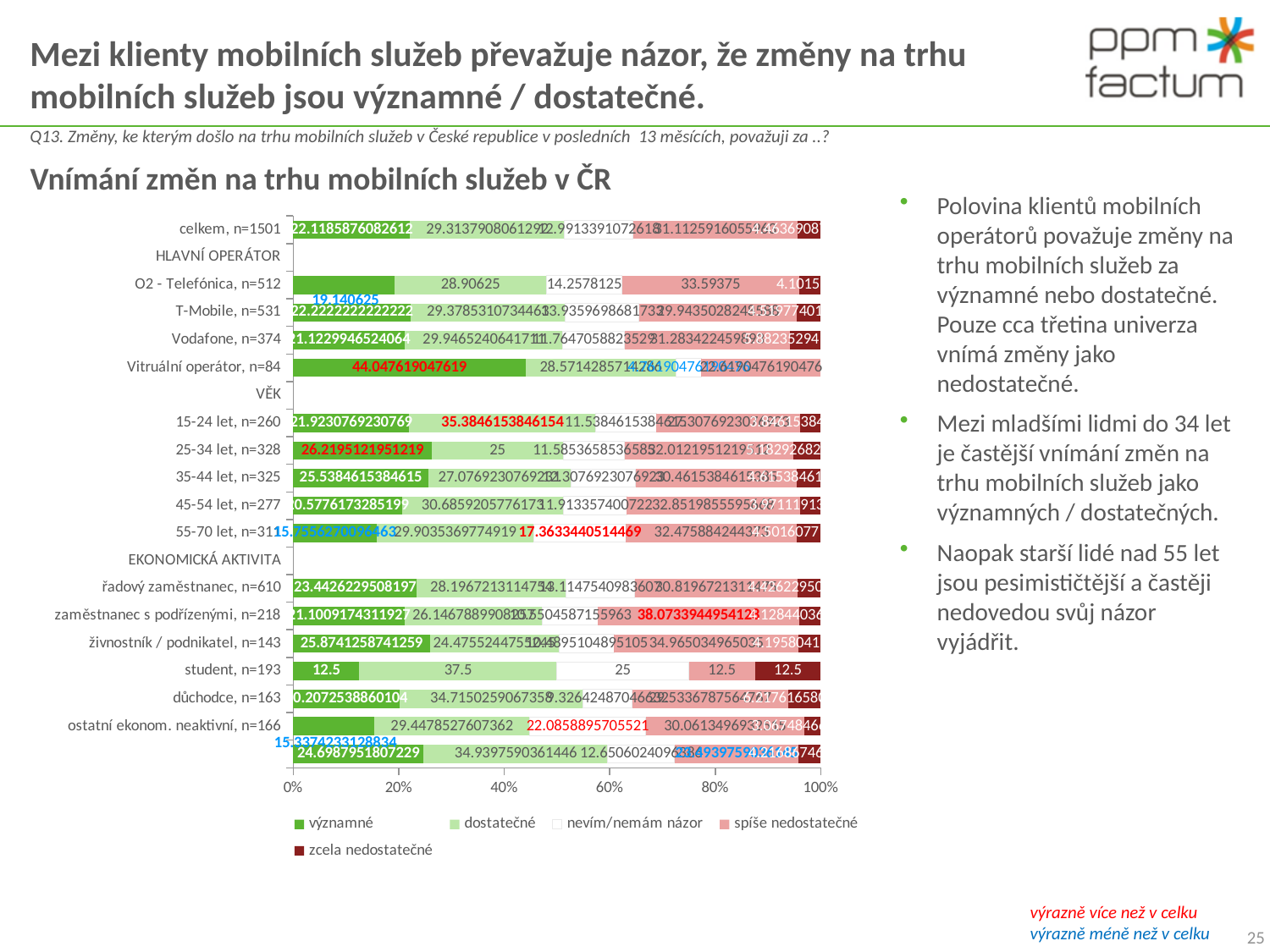
What is the value of 'dostatečné' for 25-34 let, n=328? 25 What is the value of 'dostatečné' for O2 - Telefónica, n=512? 28.90625 For O2 - Telefónica, n=512, what is the difference between 'spíše nedostatečné' and 'dostatečné'? 4.6875 How many series does the chart legend list? 5 What is the value of 'významné' for Vitruální operátor, n=84? 44.047619047619 What is the value of 'dostatečné' for 15-24 let, n=260? 35.3846153846154 What is the value of 'spíše nedostatečné' for zaměstnanec s podřízenými, n=218? 38.0733944954128 Which category has the highest 'významné' value? Vitruální operátor, n=84 What is the value of 'spíše nedostatečné' for O2 - Telefónica, n=512? 33.59375 What is the title of the chart? Vnímání změn na trhu mobilních služeb v ČR What is the value of 'nevím/nemám názor' for O2 - Telefónica, n=512? 14.2578125 What kind of chart is shown on the slide? bar chart